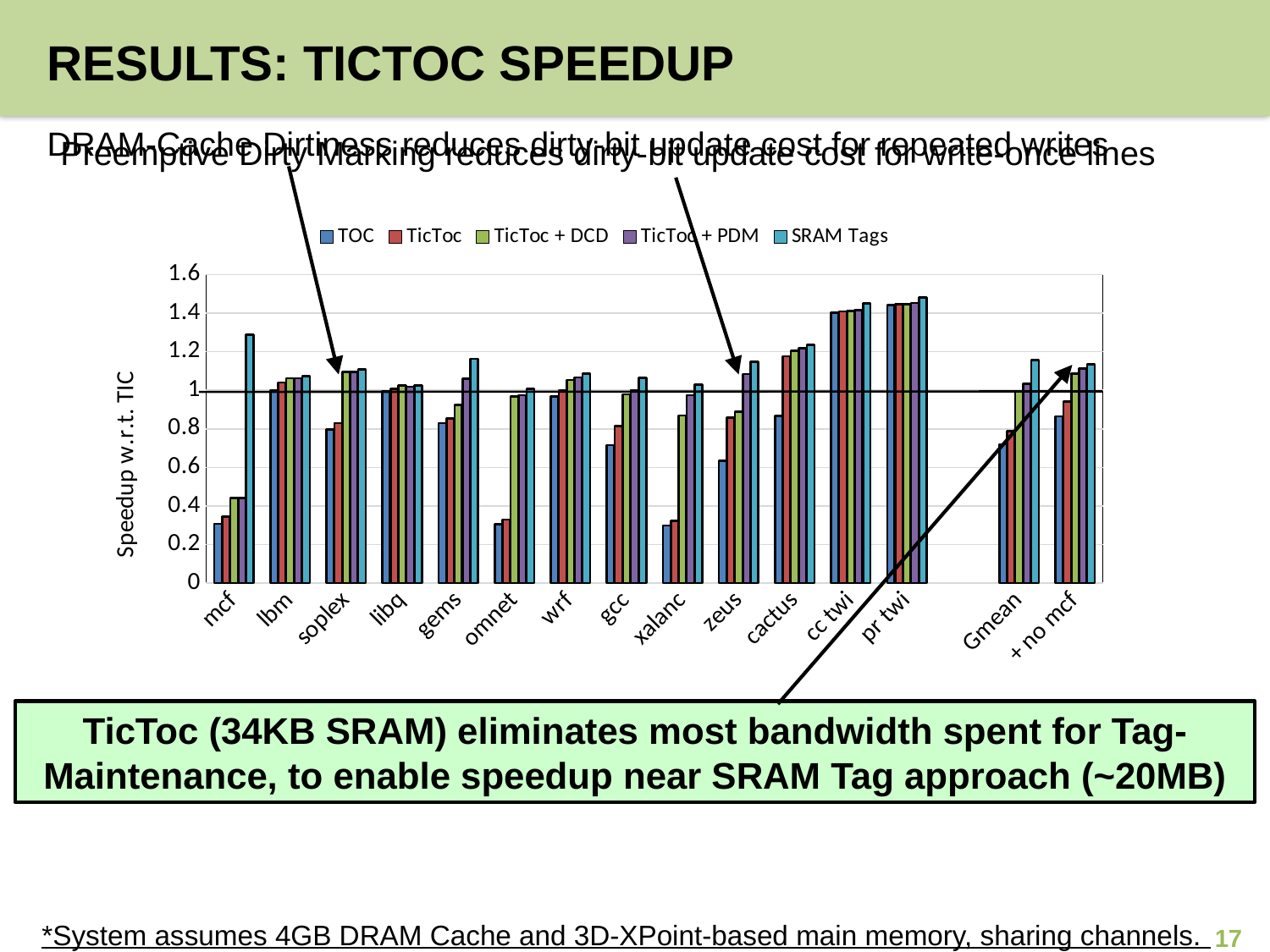
What is the label of the y axis of the chart? Speedup w.r.t. TIC What kind of chart is shown on the slide? bar chart Is the TOC value for mcf greater or less than 0.4? less Which series is listed last in the chart's legend? SRAM Tags Which is larger for mcf: the TOC value or the SRAM Tags value? SRAM Tags Is the SRAM Tags value for mcf greater or less than 1.2? greater Which category has the larger TOC value: mcf or lbm? lbm Is the TOC value for xalanc greater or less than 0.4? less How many categories are shown along the x axis of the chart? 15 How many series does the chart's legend list? 5